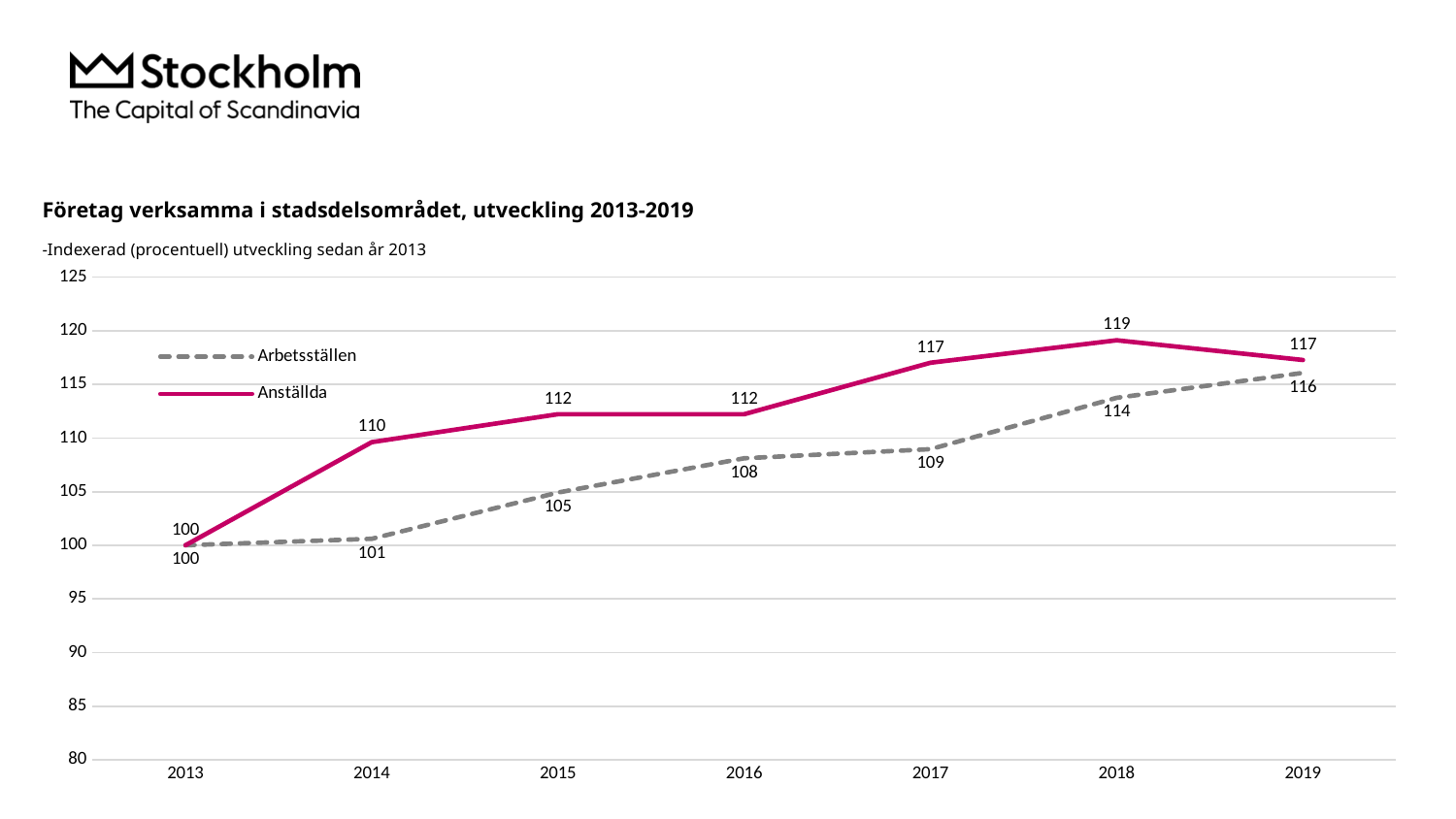
Which series is drawn with a dashed grey line? Arbetsställen What is the value for Anställda in 2018? 119 What is the difference between Anställda and Arbetsställen in 2017? 8 What kind of chart is shown on the slide? Line chart What is the value for Arbetsställen in 2016? 108 In which year is the Anställda series highest? 2018 Does the Arbetsställen series rise or fall from 2013 to 2019? Rise In which year is the Arbetsställen series lowest? 2013 Which series has the larger value in 2014, Arbetsställen or Anställda? Anställda How many years are shown on the x axis? 7 How many series does the legend list? 2 What is the value for Arbetsställen in 2019? 116